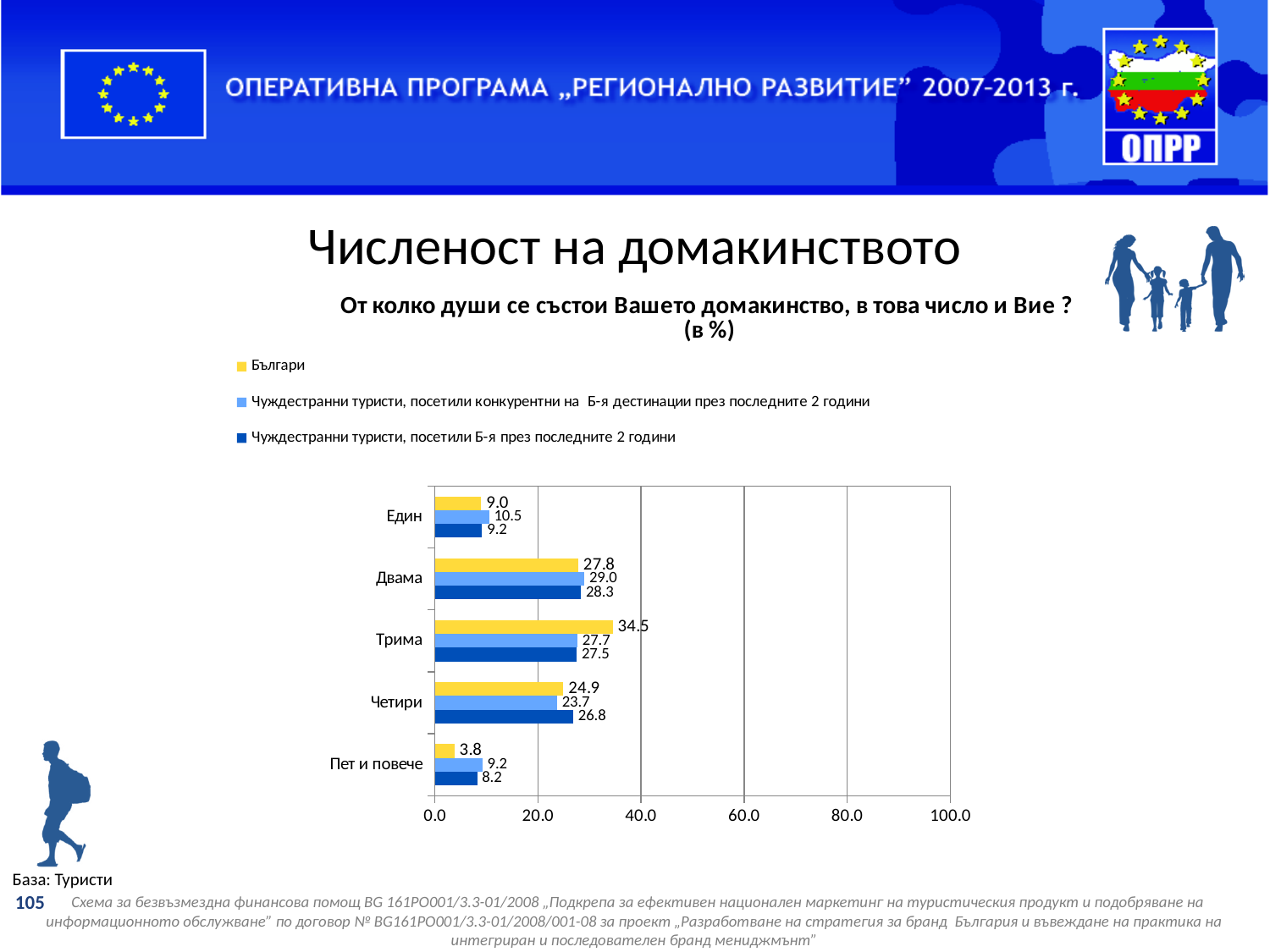
How many household-size categories are shown on the chart? 5 How many series does the legend list? 3 In the Трима category, which is larger: the value for Българи or the value for Чуждестранни туристи, посетили Б-я през последните 2 години? Българи What is the difference between the Българи value and the Чуждестранни туристи, посетили Б-я през последните 2 години value in the Пет и повече category? 4.4 What is the value for Чуждестранни туристи, посетили Б-я през последните 2 години in the Четири category? 26.8 Which category has the lowest value for Българи? Пет и повече Which category has the highest value for Българи? Трима What is the value for Българи in the Трима category? 34.5 What kind of chart is shown on the slide? bar chart What colour represents the Българи series in the chart? yellow What is the value for Чуждестранни туристи, посетили конкурентни на Б-я дестинации през последните 2 години in the Един category? 10.5 Is the value for Българи in the Двама category greater or less than 20.0? greater